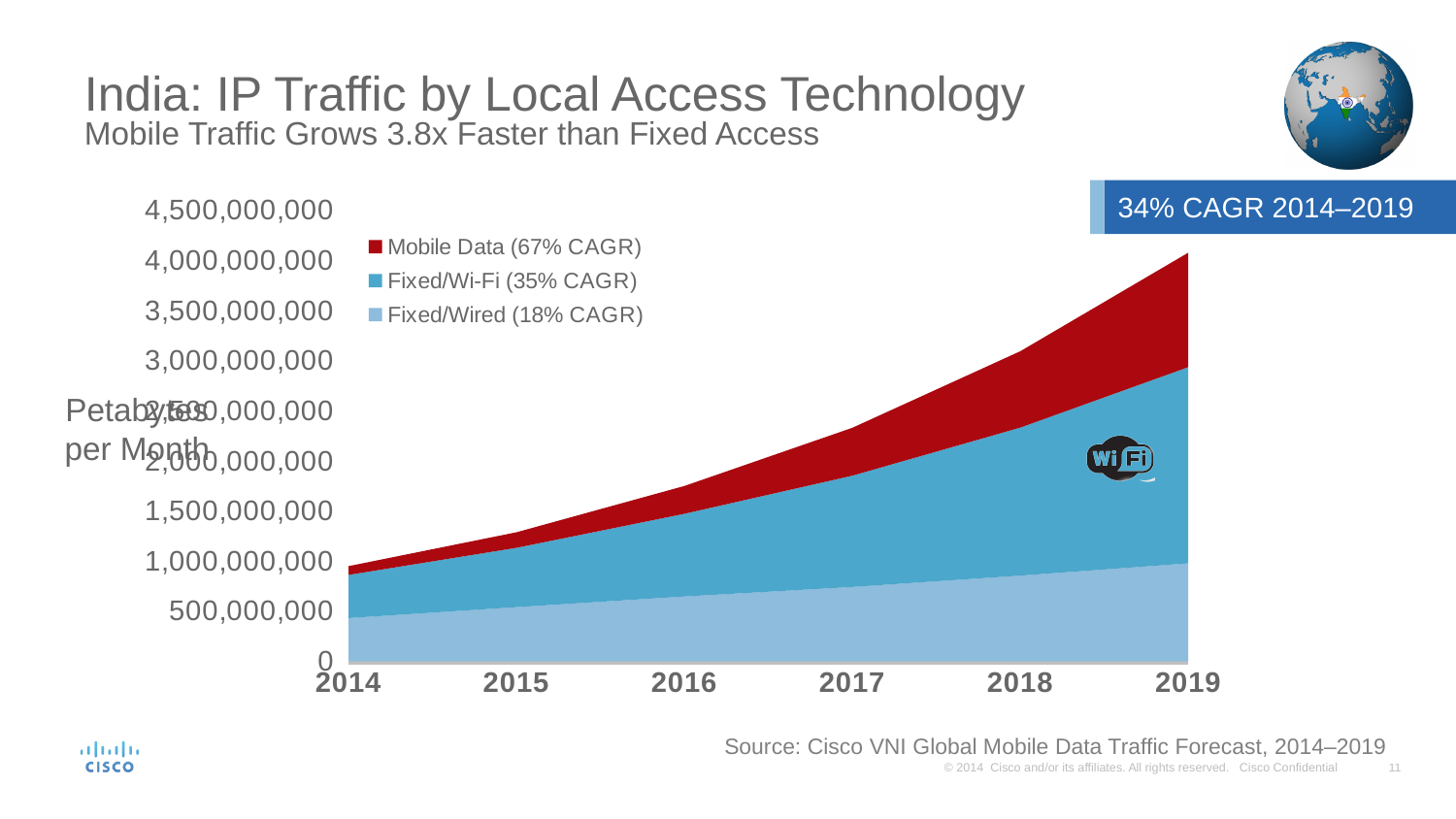
What overall CAGR for 2014–2019 is shown in the callout on the chart? 34% CAGR 2014–2019 Is the Fixed/Wired value in 2017 greater or less than 500,000,000? greater Which series is the smallest in 2014? Mobile Data (67% CAGR) Is the total IP traffic in 2016 greater or less than 1,500,000,000? greater Is the total IP traffic in 2015 greater or less than 1,000,000,000? greater Does total IP traffic rise or fall from 2014 to 2019? Rises What CAGR does the legend give for Mobile Data? 67% CAGR What kind of chart is shown on the slide? Stacked area chart Which series is the largest in 2019? Fixed/Wi-Fi (35% CAGR) How many years are shown along the x axis? 6 How many series does the legend list? 3